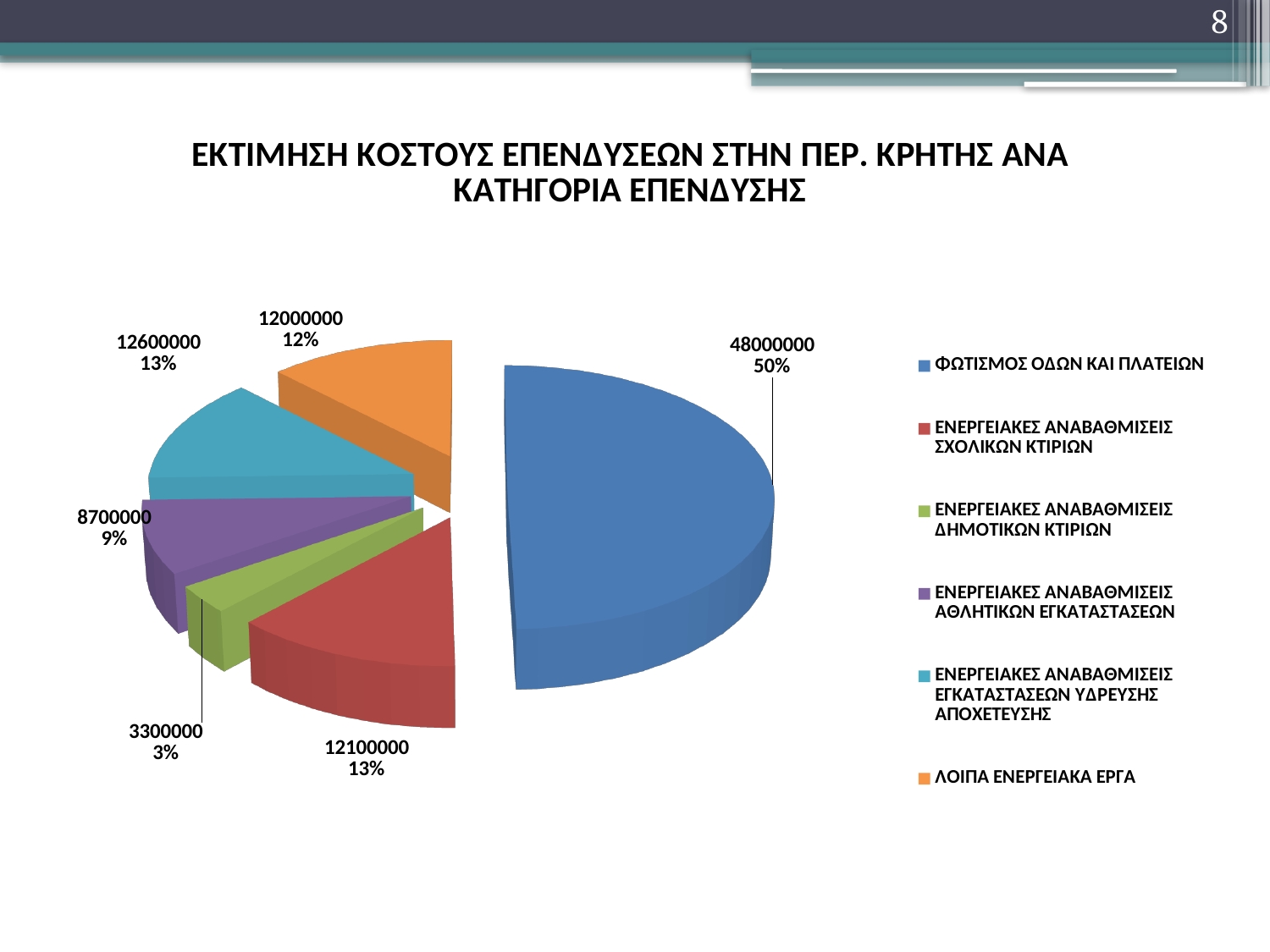
What is the difference between the value for ΕΝΕΡΓΕΙΑΚΕΣ ΑΝΑΒΑΘΜΙΣΕΙΣ ΕΓΚΑΤΑΣΤΑΣΕΩΝ ΥΔΡΕΥΣΗΣ ΑΠΟΧΕΤΕΥΣΗΣ and the value for ΕΝΕΡΓΕΙΑΚΕΣ ΑΝΑΒΑΘΜΙΣΕΙΣ ΣΧΟΛΙΚΩΝ ΚΤΙΡΙΩΝ? 500000 How many categories does the pie chart have? 6 Which category has the largest slice? ΦΩΤΙΣΜΟΣ ΟΔΩΝ ΚΑΙ ΠΛΑΤΕΙΩΝ What type of chart is shown on the slide? pie chart What is the value for ΕΝΕΡΓΕΙΑΚΕΣ ΑΝΑΒΑΘΜΙΣΕΙΣ ΔΗΜΟΤΙΚΩΝ ΚΤΙΡΙΩΝ? 3300000 What share of the pie does ΦΩΤΙΣΜΟΣ ΟΔΩΝ ΚΑΙ ΠΛΑΤΕΙΩΝ represent? 50% Which is larger: the value for ΕΝΕΡΓΕΙΑΚΕΣ ΑΝΑΒΑΘΜΙΣΕΙΣ ΑΘΛΗΤΙΚΩΝ ΕΓΚΑΤΑΣΤΑΣΕΩΝ or the value for ΛΟΙΠΑ ΕΝΕΡΓΕΙΑΚΑ ΕΡΓΑ? ΛΟΙΠΑ ΕΝΕΡΓΕΙΑΚΑ ΕΡΓΑ What share of the pie does ΕΝΕΡΓΕΙΑΚΕΣ ΑΝΑΒΑΘΜΙΣΕΙΣ ΕΓΚΑΤΑΣΤΑΣΕΩΝ ΥΔΡΕΥΣΗΣ ΑΠΟΧΕΤΕΥΣΗΣ represent? 13% What is the value for ΕΝΕΡΓΕΙΑΚΕΣ ΑΝΑΒΑΘΜΙΣΕΙΣ ΑΘΛΗΤΙΚΩΝ ΕΓΚΑΤΑΣΤΑΣΕΩΝ? 8700000 What is the value for ΦΩΤΙΣΜΟΣ ΟΔΩΝ ΚΑΙ ΠΛΑΤΕΙΩΝ? 48000000 Which category has the smallest slice? ΕΝΕΡΓΕΙΑΚΕΣ ΑΝΑΒΑΘΜΙΣΕΙΣ ΔΗΜΟΤΙΚΩΝ ΚΤΙΡΙΩΝ What is the value for ΛΟΙΠΑ ΕΝΕΡΓΕΙΑΚΑ ΕΡΓΑ? 12000000